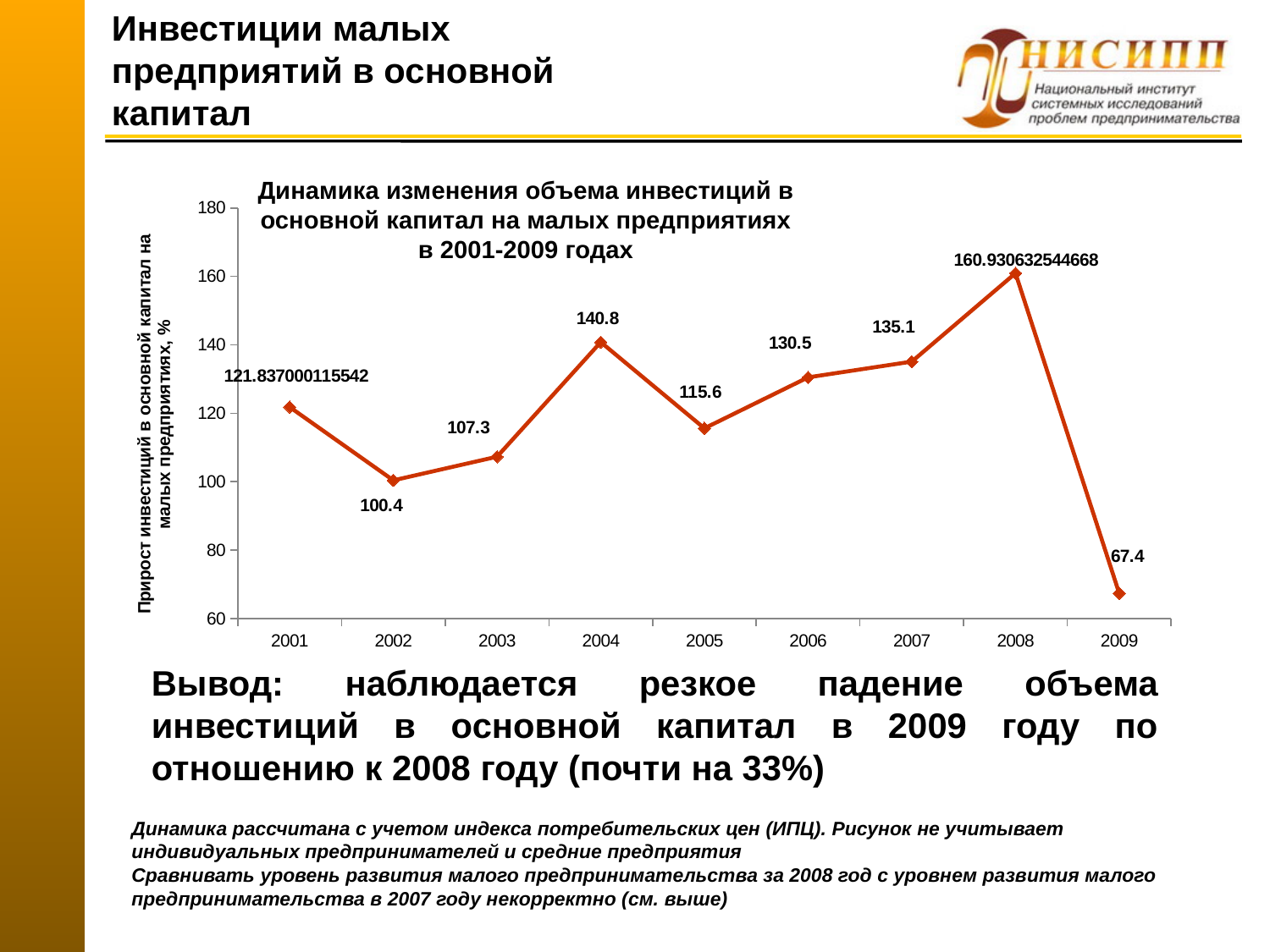
What is the value for 2007? 135.1 Which year has the highest value? 2008 How many years are plotted on the x axis? 9 What is the value for 2009? 67.4 Is the value for 2001 greater or less than 120? greater What is the value for 2004? 140.8 What is the value for 2002? 100.4 Does the value rise or fall from 2008 to 2009? fall Which is larger, the value for 2006 or the value for 2003? 2006 What kind of chart is shown on the slide? line chart Which year has the lowest value? 2009 What is the difference between the values for 2004 and 2005? 25.2